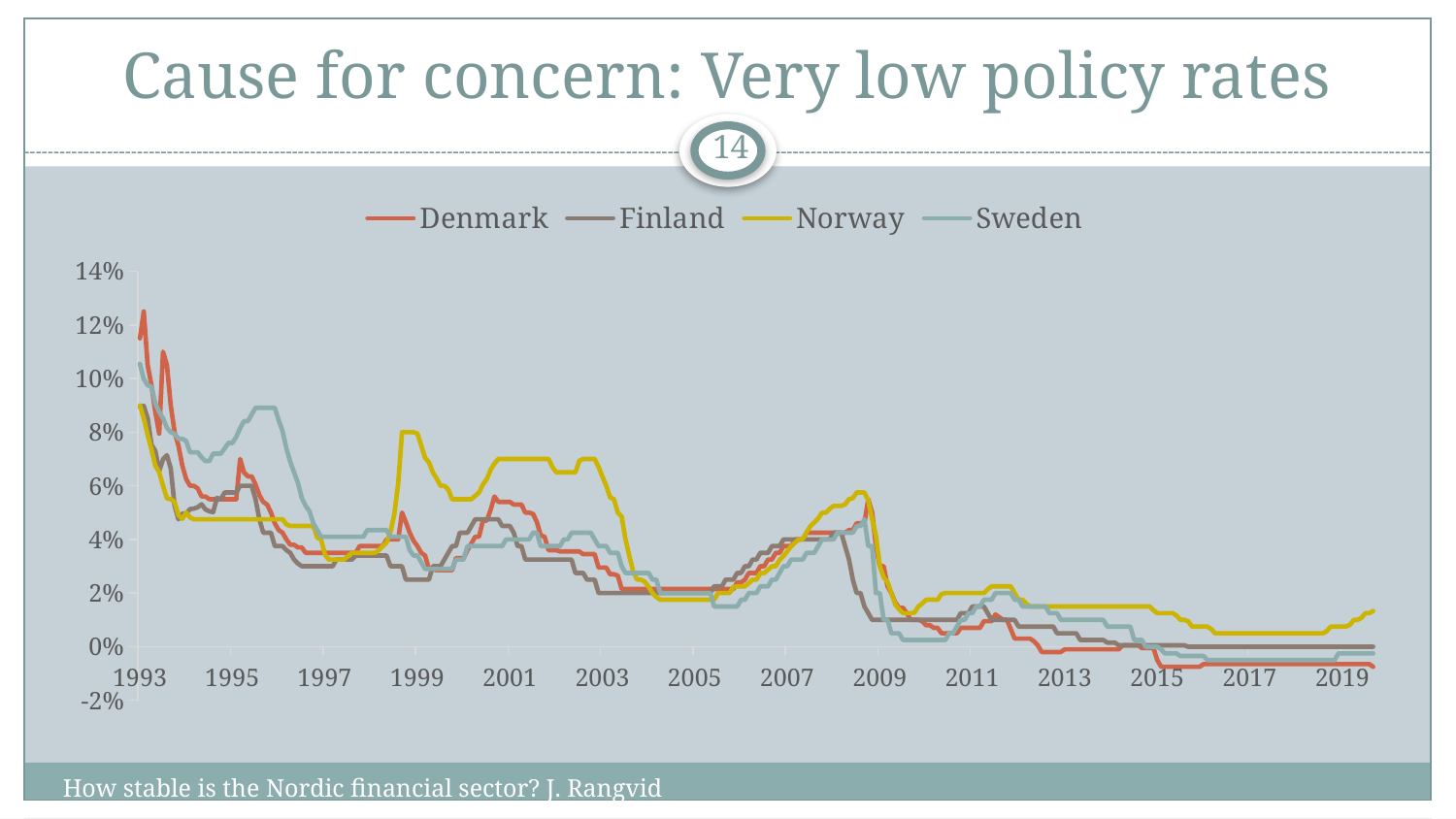
Which series is drawn in yellow? Norway Is the value for Sweden around 1996 greater or less than 6%? greater Is the value for Denmark in 2019 greater or less than 0%? less How many series does the legend list? 4 Which country has the highest policy rate around 2001? Norway Is the value for Norway in 2019 greater or less than 2%? less Overall, do the policy rates rise or fall from 1993 to 2019? fall What kind of chart is shown on the slide? line chart Which countries are listed in the chart legend? Denmark, Finland, Norway, Sweden Which country has the highest policy rate in 2019? Norway